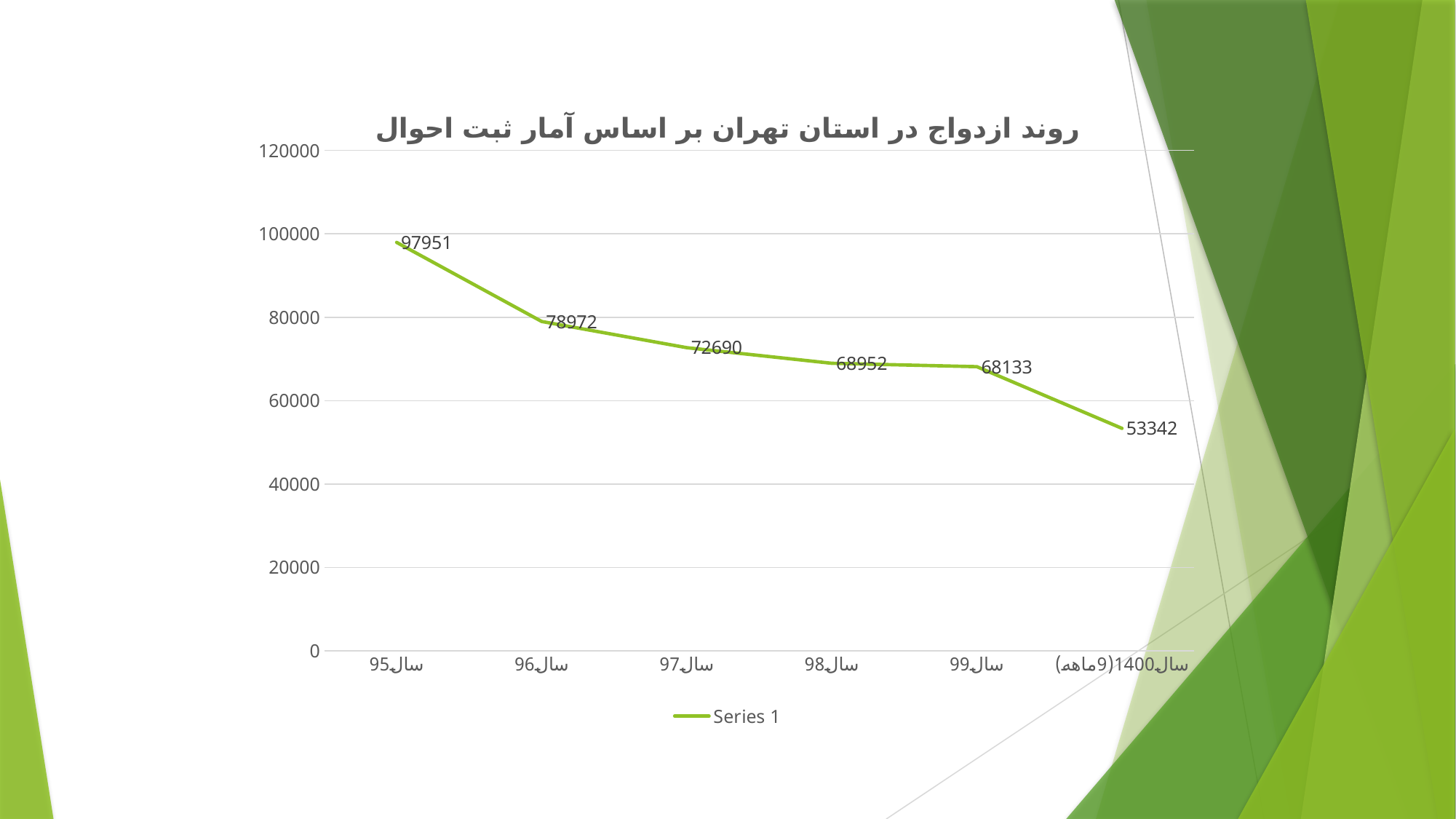
What is the value for سال1400(9ماهه)? 53342 What is the value for سال98? 68952 Which category has the highest value? سال95 What is the difference between the values for سال95 and سال96? 18979 Do the values rise or fall from سال95 to سال1400(9ماهه)? fall Which is larger, the value for سال97 or the value for سال99? سال97 What is the value for سال95? 97951 What is the difference between the values for سال99 and سال1400(9ماهه)? 14791 How many categories are shown on the x axis? 6 What kind of chart is this? line chart Which category has the lowest value? سال1400(9ماهه) Is the value for سال96 greater or less than 80000? less